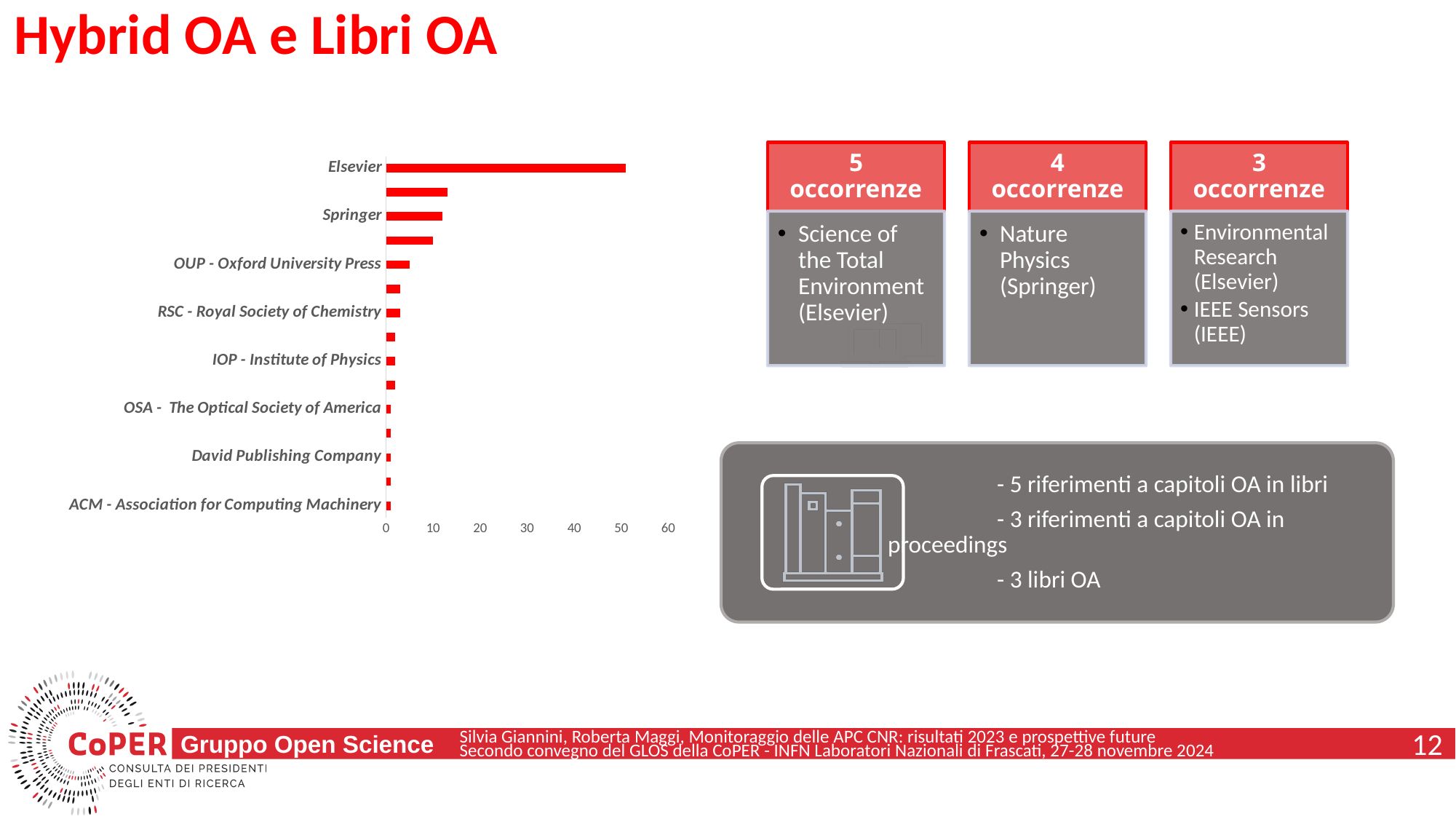
What kind of chart is shown on the slide? bar chart Which has the larger value, Springer or IOP - Institute of Physics? Springer Which has the larger value, Elsevier or Springer? Elsevier What is the highest tick value shown on the horizontal axis of the chart? 60 Is the value for Springer greater or less than 10? greater Which publisher has the longest bar in the chart? Elsevier Is the value for RSC - Royal Society of Chemistry greater or less than 10? less What colour are the bars in the chart? red Is the value for Elsevier greater or less than 40? greater Are the bars in the chart arranged from longest at the top to shortest at the bottom? yes Which has the larger value, OUP - Oxford University Press or ACM - Association for Computing Machinery? OUP - Oxford University Press